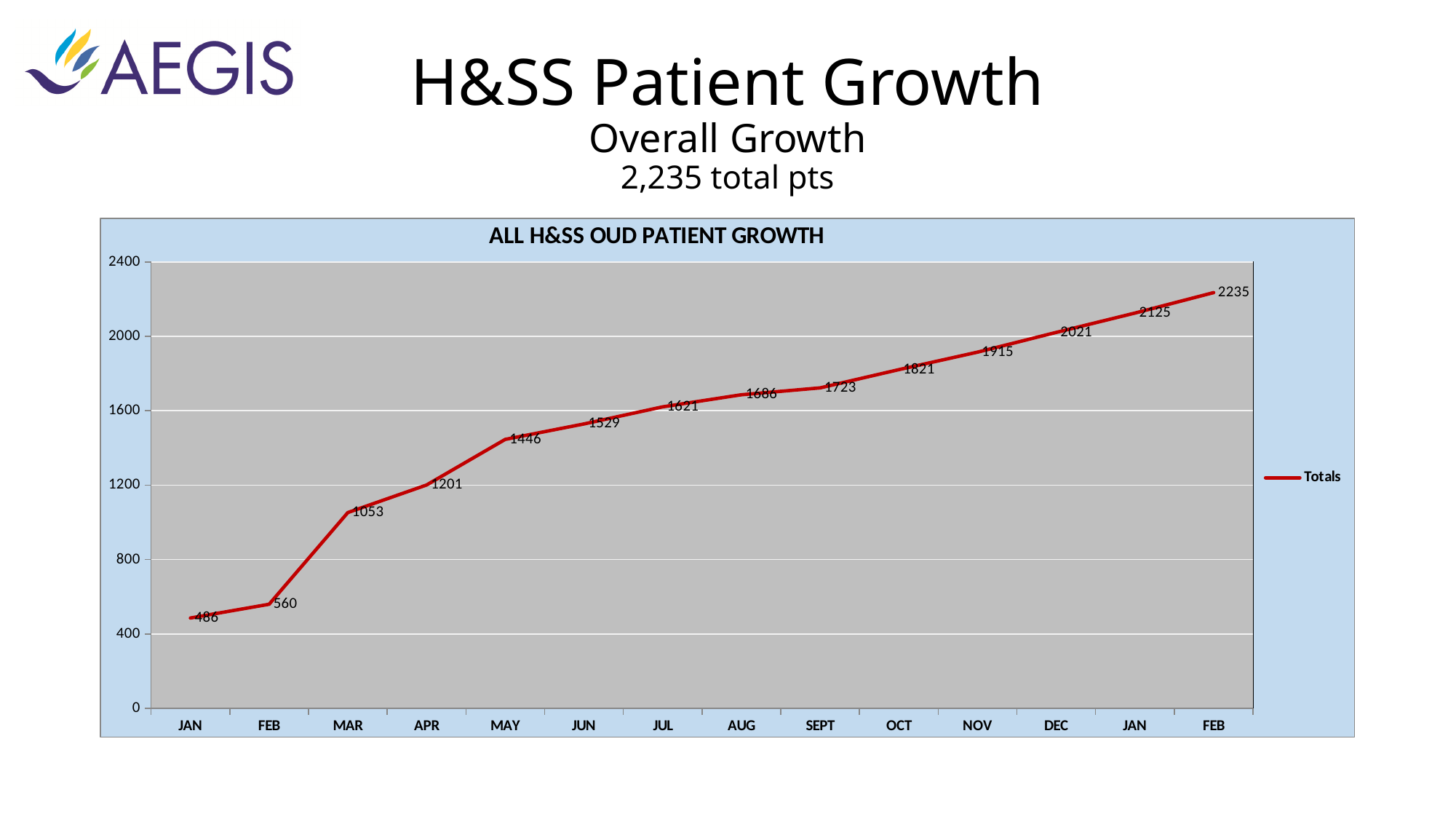
How many series does the legend list? 1 What is the difference between the values for DEC and NOV? 106 What type of chart is shown on the slide? line chart Which month has the highest value? FEB (the last one) How many data points are plotted on the line? 14 What is the value for SEPT? 1723 What is the value for the last FEB on the x axis? 2235 Do the values rise or fall from left to right along the x axis? rise Which month has the lowest value? JAN (the first one) Which is larger, the value for MAY or the value for APR? MAY What is the value for MAR? 1053 What is the title of the chart? ALL H&SS OUD PATIENT GROWTH